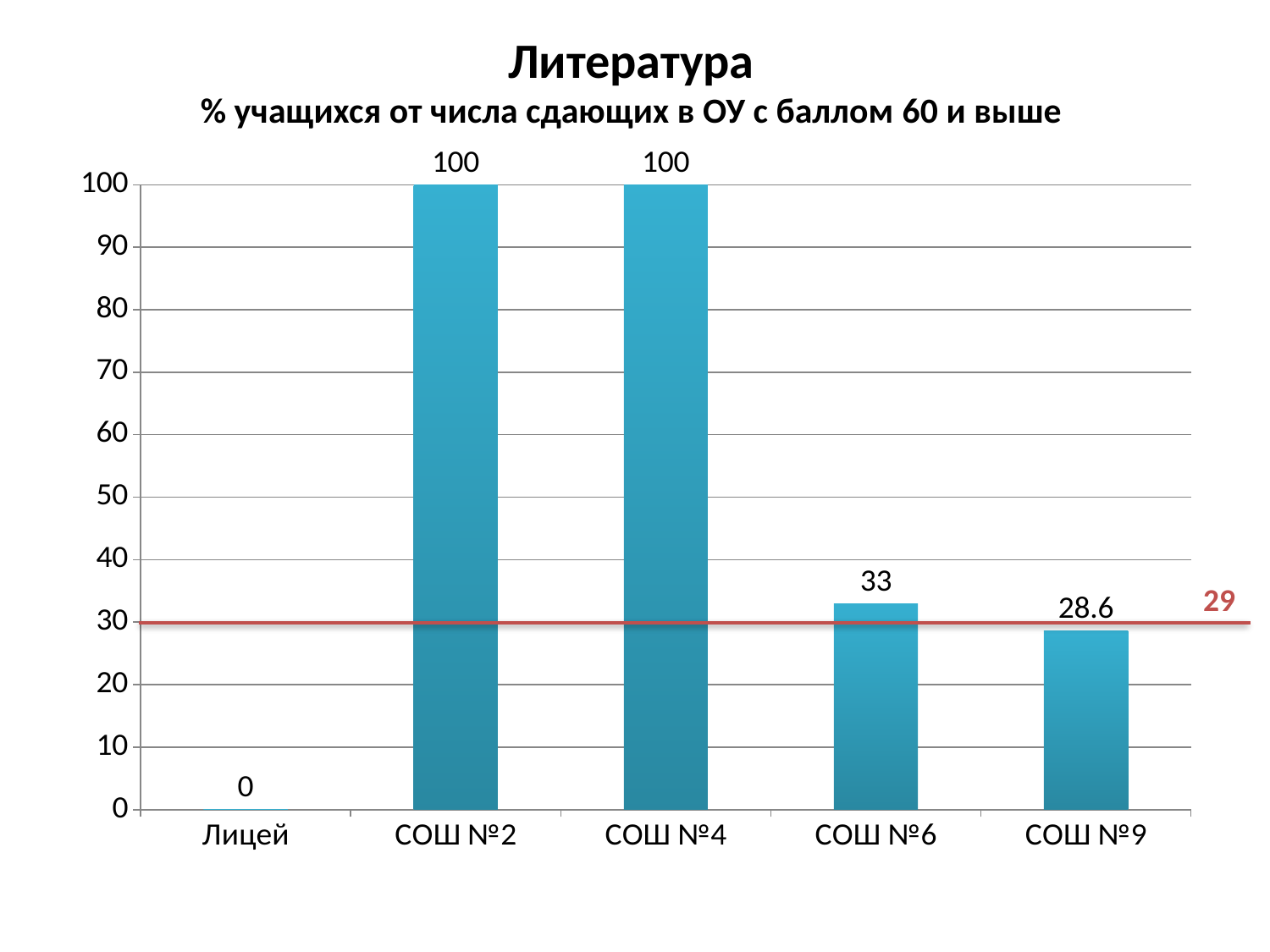
What is the value for Лицей? 0 What is the value for СОШ №9? 28.6 Which category has the lowest value? Лицей How many categories are shown on the x axis? 5 What value is labelled on the red horizontal line? 29 What kind of chart is shown on the slide? bar chart What is the value for СОШ №6? 33 Is the value for СОШ №9 greater or less than 30? less What is the difference between the values for СОШ №4 and СОШ №6? 67 What is the difference between the values for СОШ №6 and СОШ №9? 4.4 What is the value for СОШ №2? 100 Which is larger, the value for СОШ №6 or the value for СОШ №9? СОШ №6